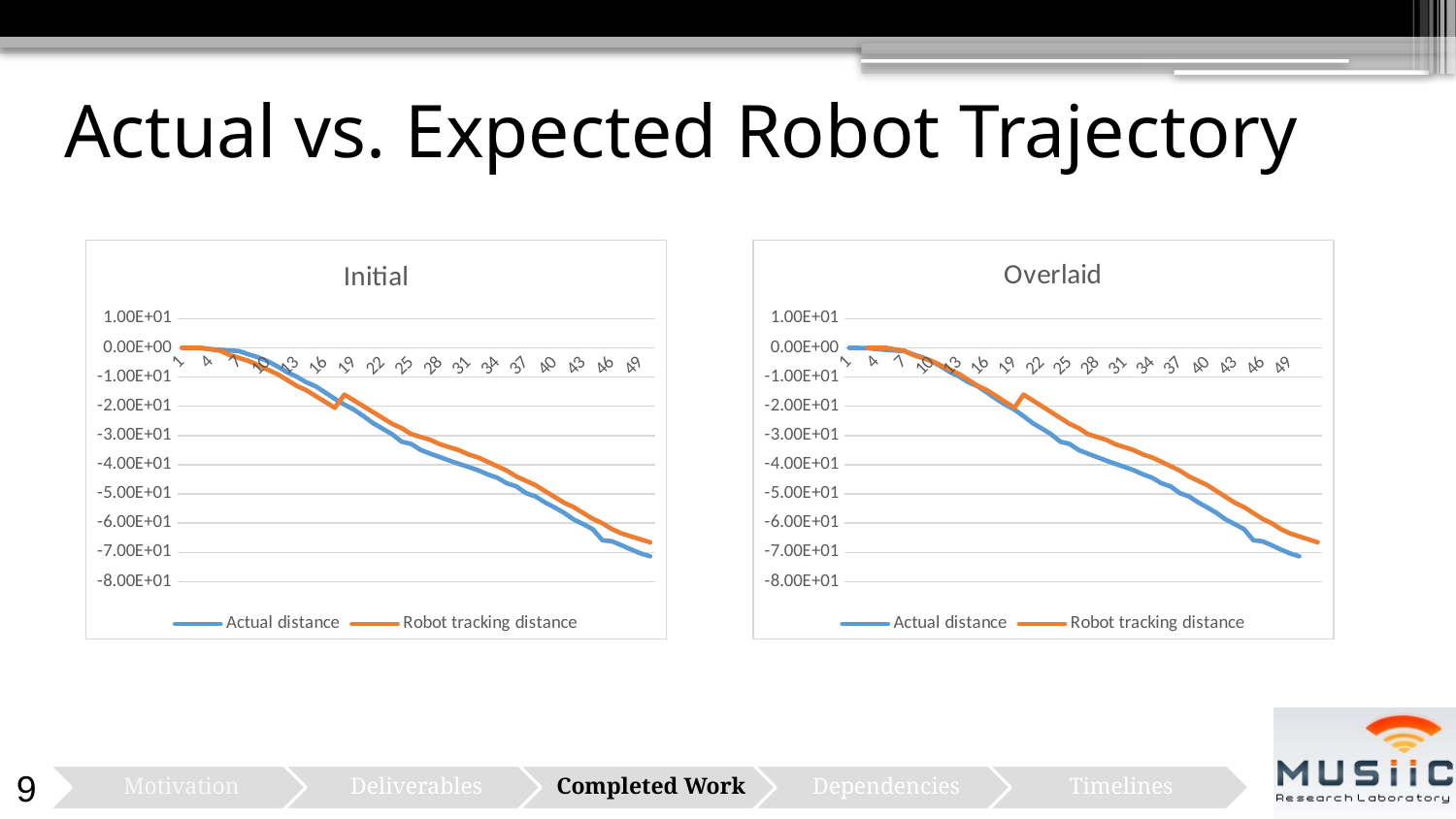
In the "Overlaid" chart, is the value of Robot tracking distance at x = 49 greater or less than -7.00E+01? greater In the "Overlaid" chart, do the values of Robot tracking distance rise or fall along the x axis? fall In the "Initial" chart, which series has the higher value at x = 49, Actual distance or Robot tracking distance? Robot tracking distance How many series does the legend of the "Overlaid" chart list? 2 What are the titles of the two charts on the slide? Initial and Overlaid How many tick labels are shown on the x axis of the "Overlaid" chart? 17 In the "Initial" chart, is the value of Actual distance at x = 49 greater or less than -6.00E+01? less In the "Initial" chart, which series is drawn in orange? Robot tracking distance In the "Initial" chart, do the values of Actual distance rise or fall as the x axis increases? fall What kind of chart is the chart titled "Initial"? line chart In the "Overlaid" chart, which series has the lower value at x = 49, Actual distance or Robot tracking distance? Actual distance In the "Initial" chart, what value does Actual distance start at when x = 1? 0.00E+00